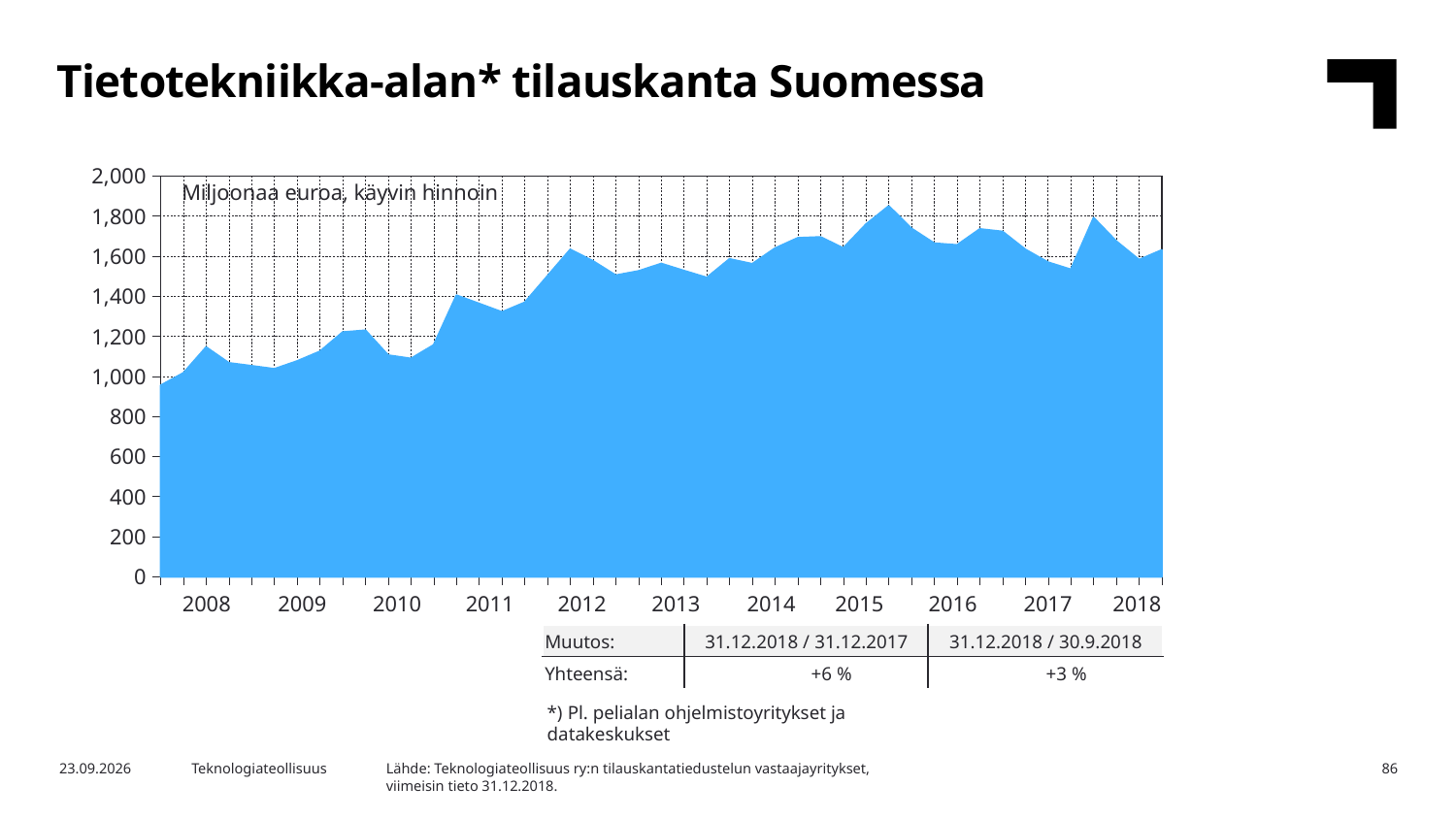
What unit is stated inside the chart area? Miljoonaa euroa, käyvin hinnoin How many years are labelled on the x axis of the chart? 11 Which is larger, the value at the start of 2008 or the value at the start of 2018? 2018 Overall, do the values rise or fall from 2008 to 2018? rise Is the value at the start of 2009 greater or less than 1,400? less What kind of chart is shown on the slide? area chart According to the table below the chart, what is the change (Muutos) for 31.12.2018 / 31.12.2017? +6 % In which year is the lowest value on the chart? 2008 In which year does the chart reach its highest value? 2015 Is the value at the start of 2010 greater or less than 1,400? less What is the title of the chart on the slide? Tietotekniikka-alan* tilauskanta Suomessa Is the value at the start of 2018 greater or less than 1,400? greater